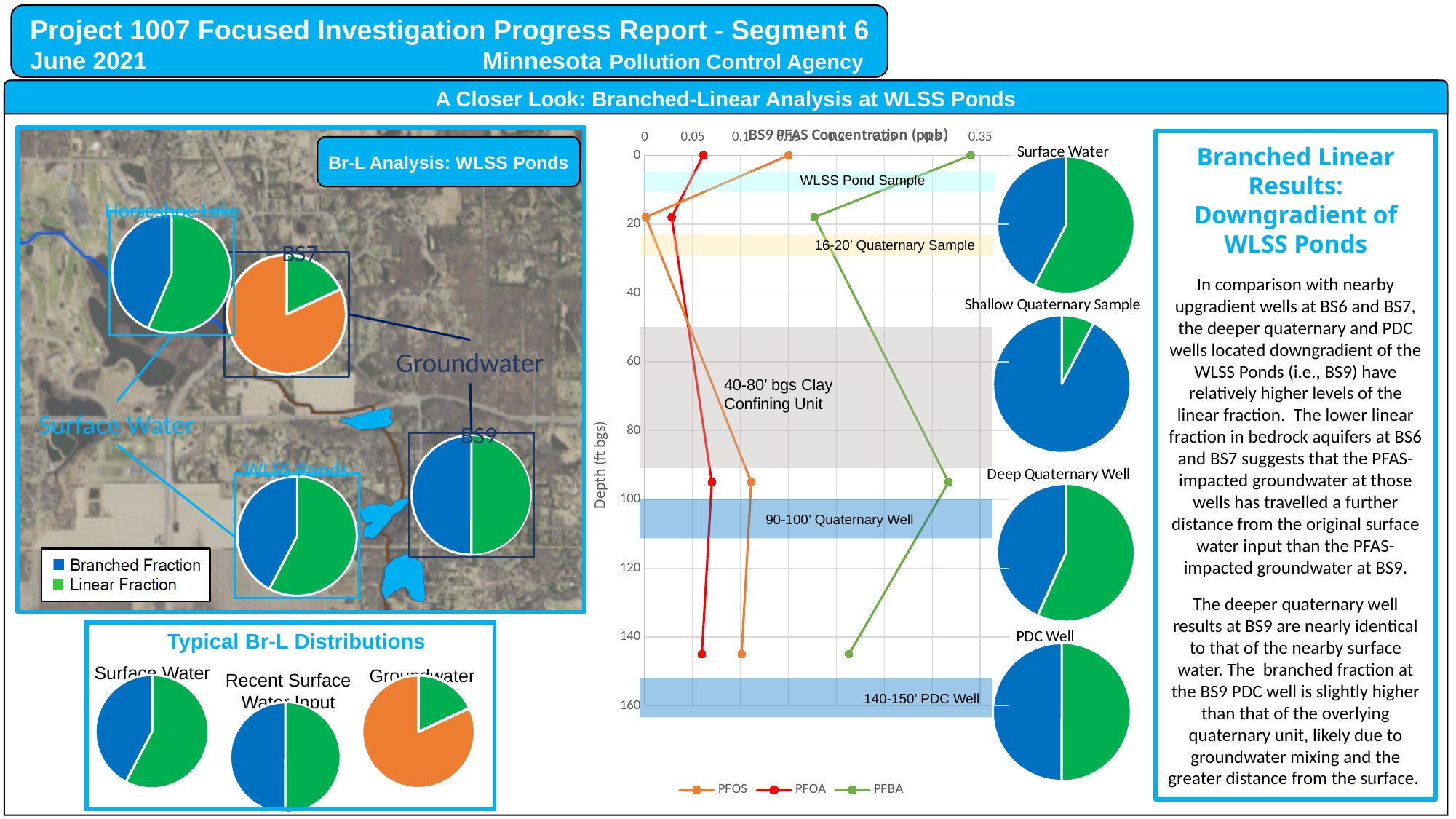
In the 'BS9 PFAS Concentration (ppb)' chart, which series has the lowest concentration at a depth of 0 ft? PFOA In the 'Shallow Quaternary Sample' pie chart, which fraction is larger, Branched Fraction or Linear Fraction? Branched Fraction In the 'BS9 PFAS Concentration (ppb)' chart, is the PFOA concentration at the 90-100' Quaternary Well depth greater or less than 0.1? less In the 'BS9 PFAS Concentration (ppb)' chart, which series is larger at the 140-150' PDC Well depth, PFOS or PFBA? PFBA How many pie charts are shown in the 'Typical Br-L Distributions' box? 3 What are the series names in the legend of the 'BS9 PFAS Concentration (ppb)' chart? PFOS, PFOA, PFBA What kind of chart is the 'BS9 PFAS Concentration (ppb)' chart? line chart What label is on the vertical axis of the 'BS9 PFAS Concentration (ppb)' chart? Depth (ft bgs) In the 'BS9 PFAS Concentration (ppb)' chart, which series has the highest concentration at a depth of 0 ft? PFBA How many series does the legend of the 'BS9 PFAS Concentration (ppb)' chart list? 3 In the 'BS9 PFAS Concentration (ppb)' chart, is the PFBA concentration at the 90-100' Quaternary Well depth greater or less than 0.3? greater In the 'BS9 PFAS Concentration (ppb)' chart, is the PFBA concentration at a depth of 0 ft greater or less than 0.3? greater